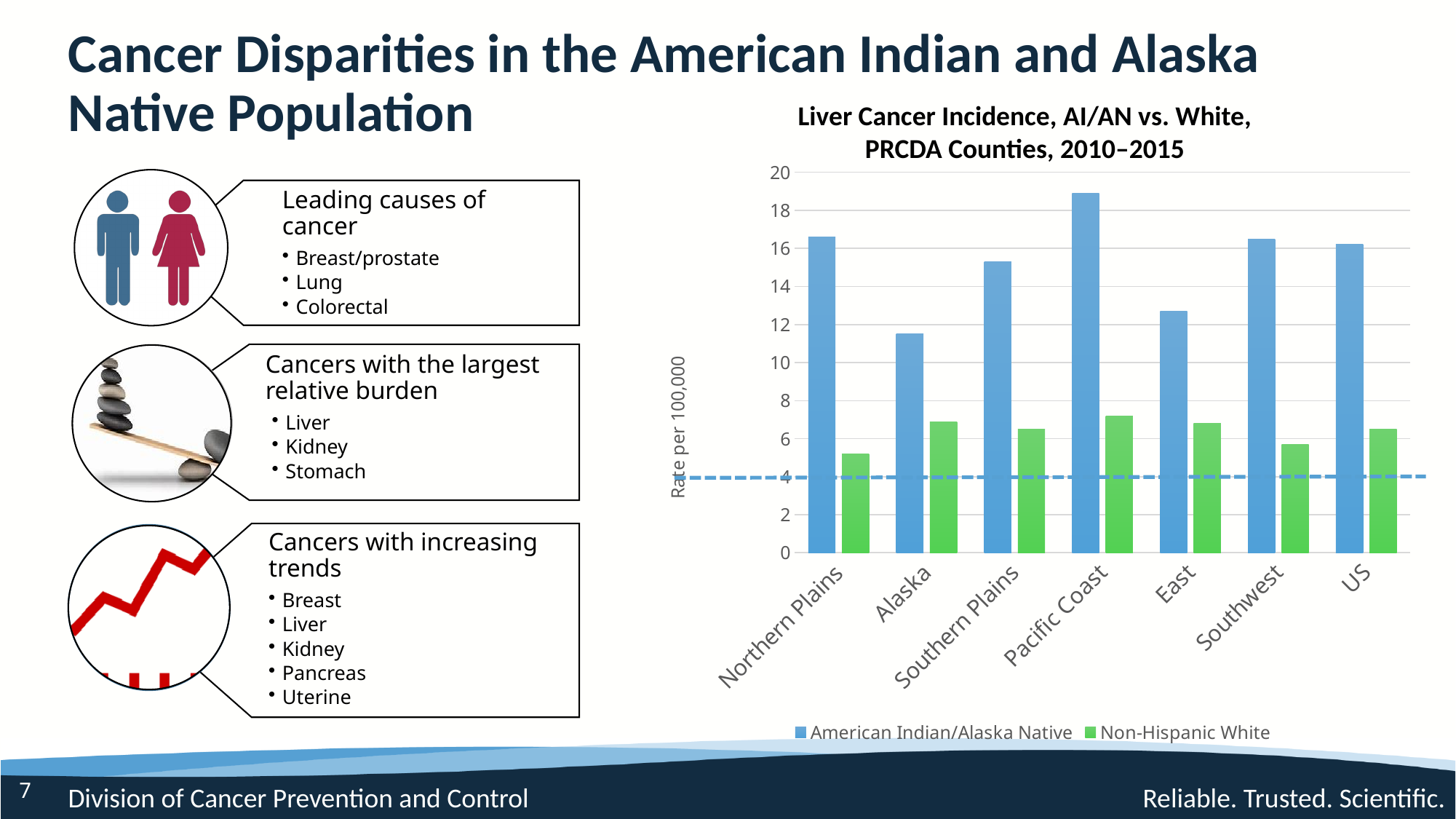
What kind of chart is shown on the slide? Bar chart Which is larger: the American Indian/Alaska Native rate for Northern Plains or for Alaska? Northern Plains What is the title of the chart? Liver Cancer Incidence, AI/AN vs. White, PRCDA Counties, 2010–2015 Is the American Indian/Alaska Native rate for Pacific Coast greater or less than 18? greater Which region has the highest American Indian/Alaska Native liver cancer incidence rate? Pacific Coast Is the American Indian/Alaska Native rate for East greater or less than 14? less Is the Non-Hispanic White rate for Northern Plains greater or less than 6? less How many series does the chart legend list? 2 What is the label of the y axis of the chart? Rate per 100,000 Which region has the lowest American Indian/Alaska Native liver cancer incidence rate? Alaska How many regions (categories) are shown on the x axis of the chart? 7